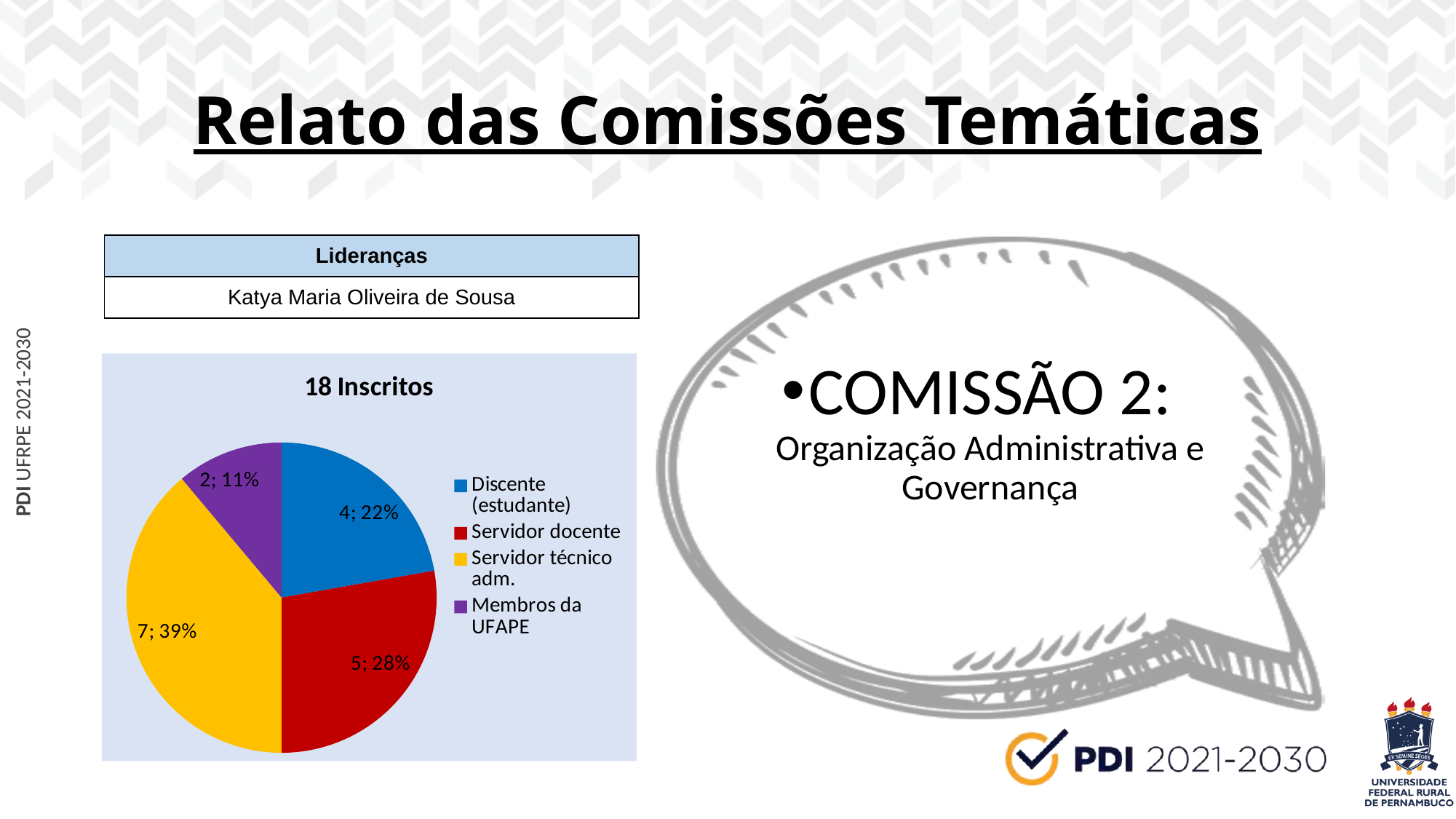
What colour represents Servidor técnico adm. in the pie chart? yellow Which is larger: Servidor docente or Discente (estudante)? Servidor docente How many people are in the Discente (estudante) category? 4 How many categories does the pie chart show? 4 What kind of chart is shown on the slide? pie chart What is the title of the pie chart? 18 Inscritos Which category has the smallest slice of the pie chart? Membros da UFAPE What percentage share does Servidor docente have in the pie chart? 28% What is the difference between the number of Servidor técnico adm. and Discente (estudante)? 3 Which category has the largest slice of the pie chart? Servidor técnico adm. What is the value for Servidor técnico adm.? 7 What percentage share does Membros da UFAPE have? 11%